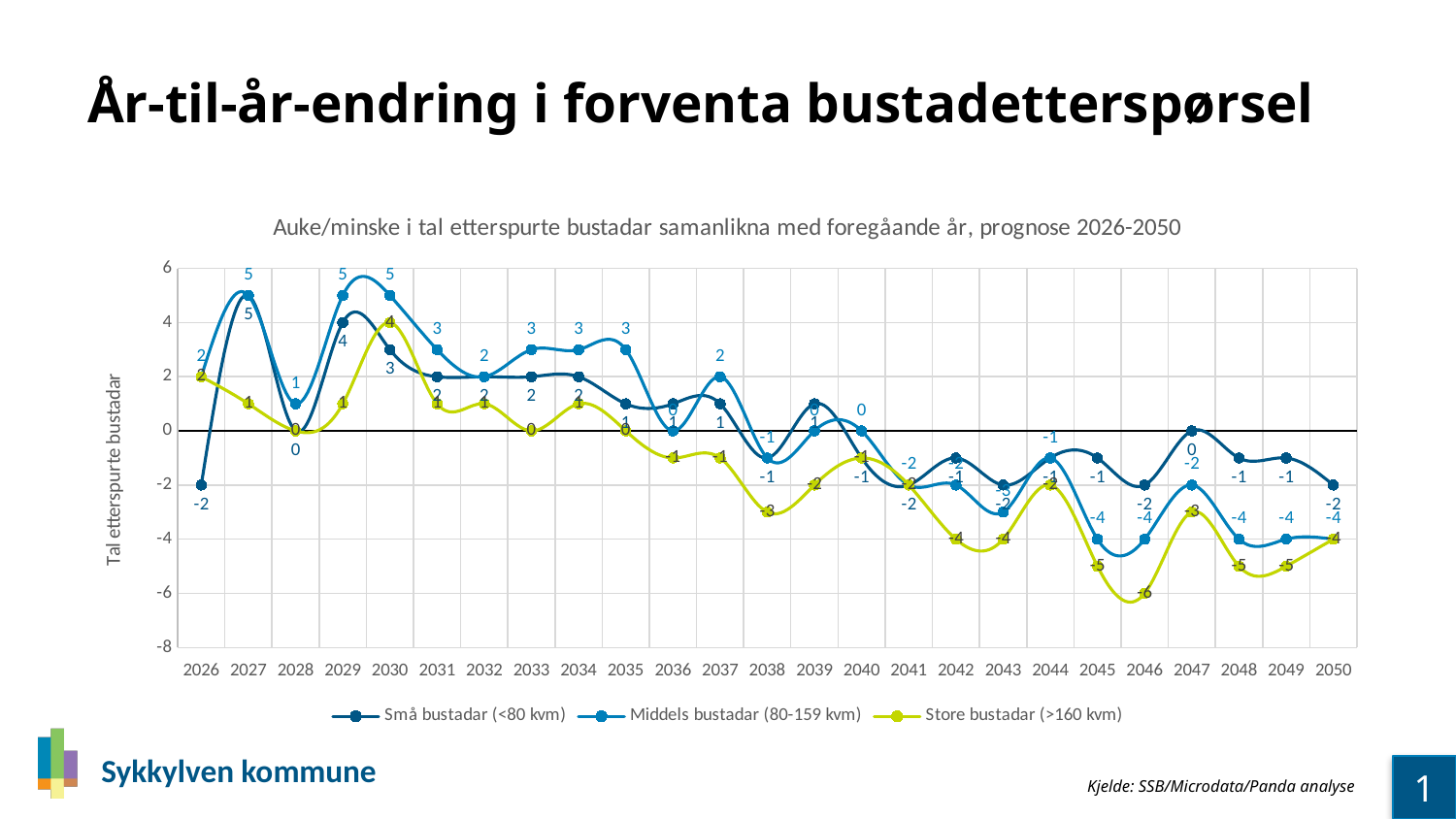
What is the value for Store bustadar (>160 kvm) in 2046? -6 What kind of chart is shown on the slide? Line chart What is the value for Store bustadar (>160 kvm) in 2038? -3 How many years are plotted along the x axis? 25 What is the value for Middels bustadar (80-159 kvm) in 2030? 5 Do the values for Store bustadar (>160 kvm) generally rise or fall from 2026 to 2050? Fall In which year does Store bustadar (>160 kvm) reach its lowest value? 2046 What is the difference between Middels bustadar (80-159 kvm) and Store bustadar (>160 kvm) in 2046? 2 What is the value for Små bustadar (<80 kvm) in 2026? -2 In which year does Store bustadar (>160 kvm) reach its highest value? 2030 In 2045, which is larger: Middels bustadar (80-159 kvm) or Store bustadar (>160 kvm)? Middels bustadar (80-159 kvm) How many series does the legend list? 3